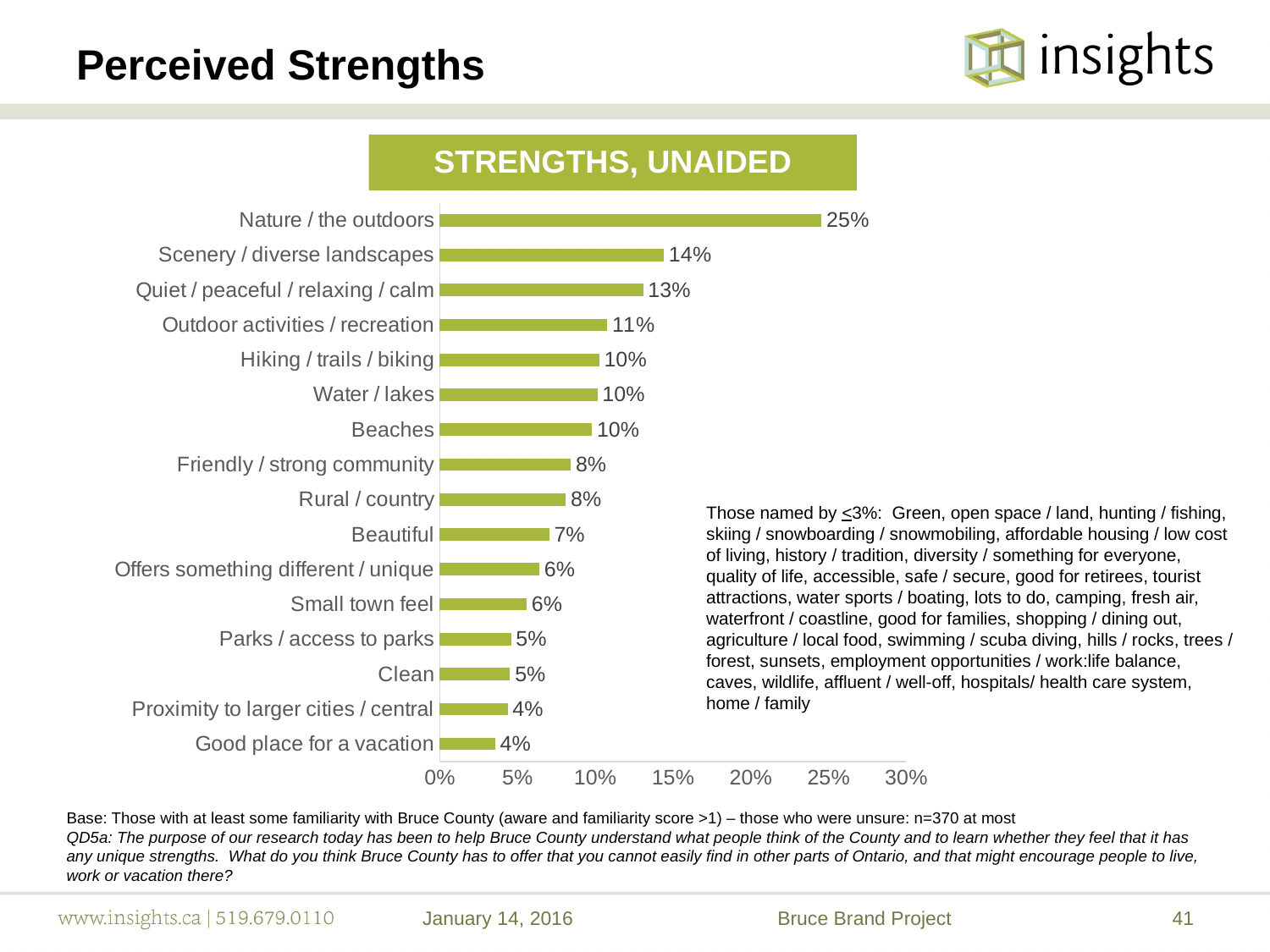
What is the value for Small town feel? 6% What kind of chart is shown on the slide? Bar chart What is the title of the chart? STRENGTHS, UNAIDED How many categories are plotted in the chart? 16 What is the value for Quiet / peaceful / relaxing / calm? 13% What is the difference between the values for Nature / the outdoors and Scenery / diverse landscapes? 11% What is the highest value shown on the x axis? 30% What is the difference between the values for Friendly / strong community and Good place for a vacation? 4% Which is larger, the value for Beautiful or the value for Clean? Beautiful Which category has the highest value in the chart? Nature / the outdoors Is the value for Outdoor activities / recreation greater or less than 10%? greater What percentage of respondents named Nature / the outdoors as a strength? 25%